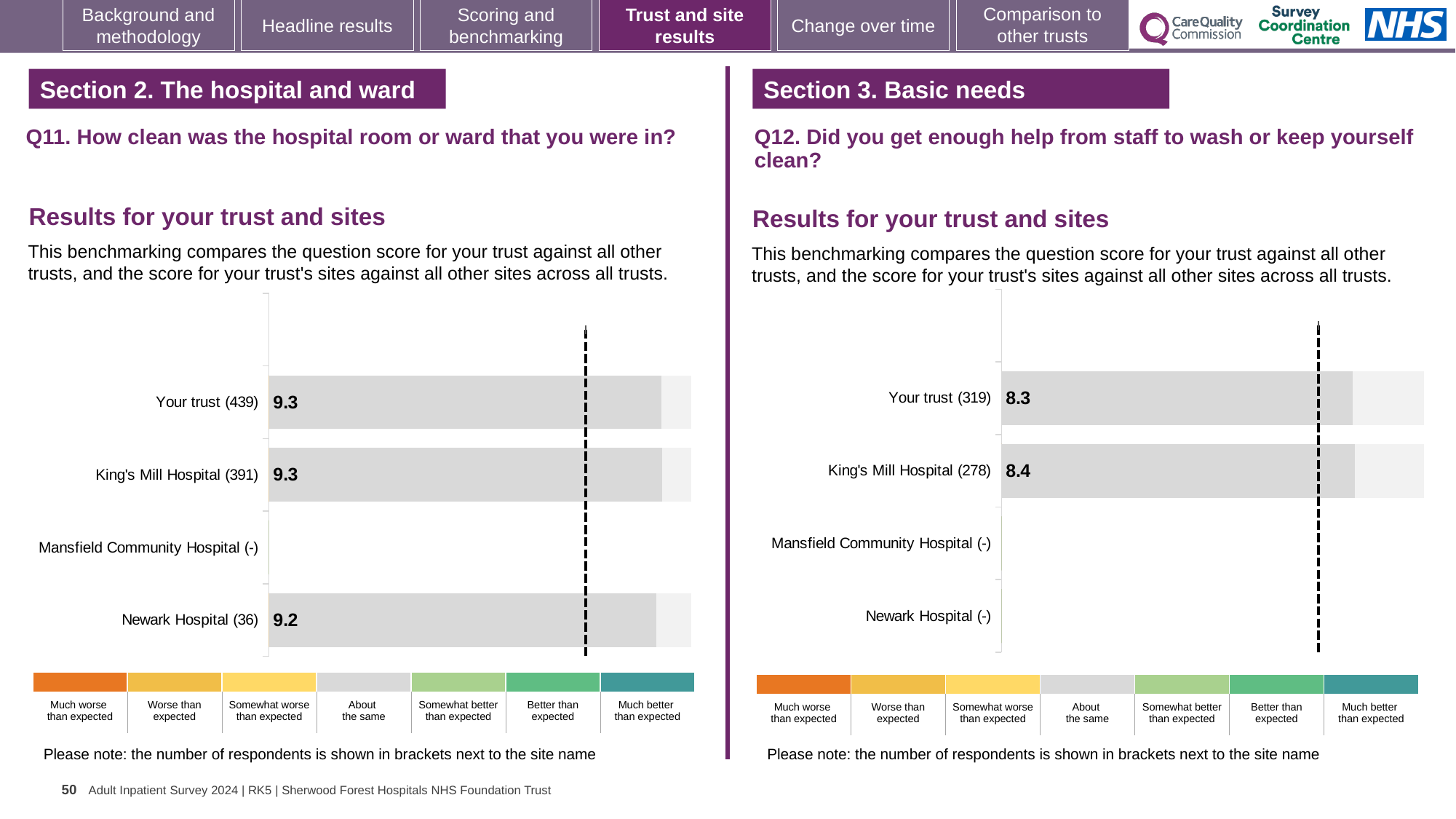
What kind of chart is used on the left-hand side of the slide for Q11? Bar chart In the Q11 chart, what is the difference between the score for Your trust and the score for Newark Hospital? 0.1 In the Q12 chart, what is the score for King's Mill Hospital? 8.4 In the Q11 chart, what is the score for Newark Hospital? 9.2 In the Q11 chart, what is the score for King's Mill Hospital? 9.3 In the Q11 chart (How clean was the hospital room or ward), what is the score for Your trust? 9.3 In the Q11 chart, how many respondents are shown in brackets for Newark Hospital? 36 In the Q12 chart, which site has the higher score, Your trust or King's Mill Hospital? King's Mill Hospital In the Q12 chart (Did you get enough help from staff to wash or keep yourself clean), what is the score for Your trust? 8.3 How many site/trust categories are listed on the Q11 chart? 4 In the Q12 chart, what is the difference between the King's Mill Hospital score and the Your trust score? 0.1 In the Q12 chart, how many respondents are shown in brackets for Your trust? 319